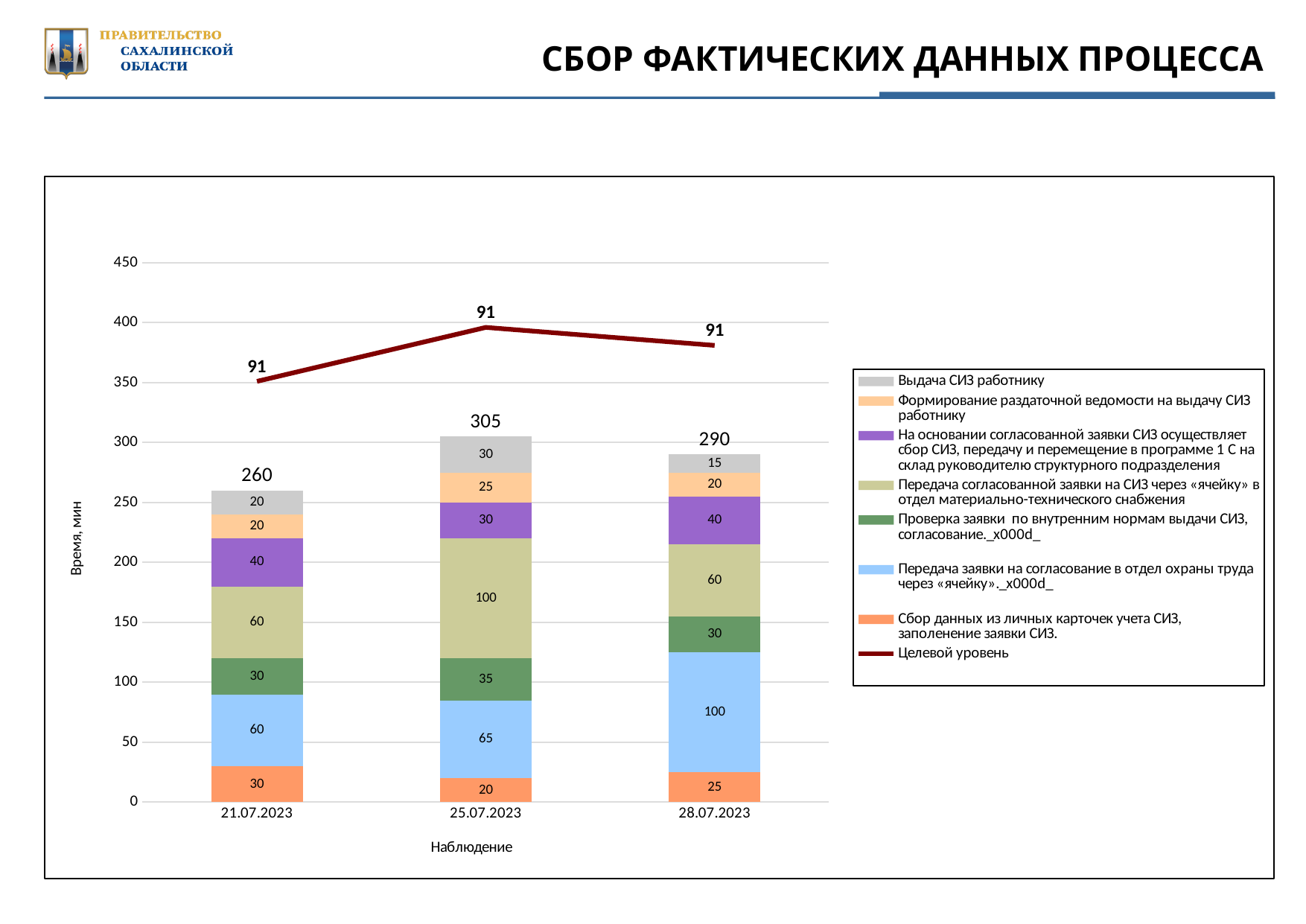
What is the value of the 'Выдача СИЗ работнику' segment for 25.07.2023? 30 What is the value of the 'Передача заявки на согласование в отдел охраны труда через «ячейку»' segment for 28.07.2023? 100 What is the total time shown above the stacked bar for 25.07.2023? 305 Which observation date has the lowest total time? 21.07.2023 What is the difference between the total time for 25.07.2023 and the total time for 28.07.2023? 15 How many entries does the legend list? 8 Which is larger: the 'Передача согласованной заявки на СИЗ через «ячейку» в отдел материально-технического снабжения' segment for 25.07.2023 or for 28.07.2023? 25.07.2023 Which observation date has the highest total time? 25.07.2023 What is the total time shown above the stacked bar for 21.07.2023? 260 How many observation dates are shown on the x axis? 3 What is the value of the 'Сбор данных из личных карточек учета СИЗ, заполнение заявки СИЗ.' segment for 21.07.2023? 30 What value is labelled on the 'Целевой уровень' line at 28.07.2023? 91